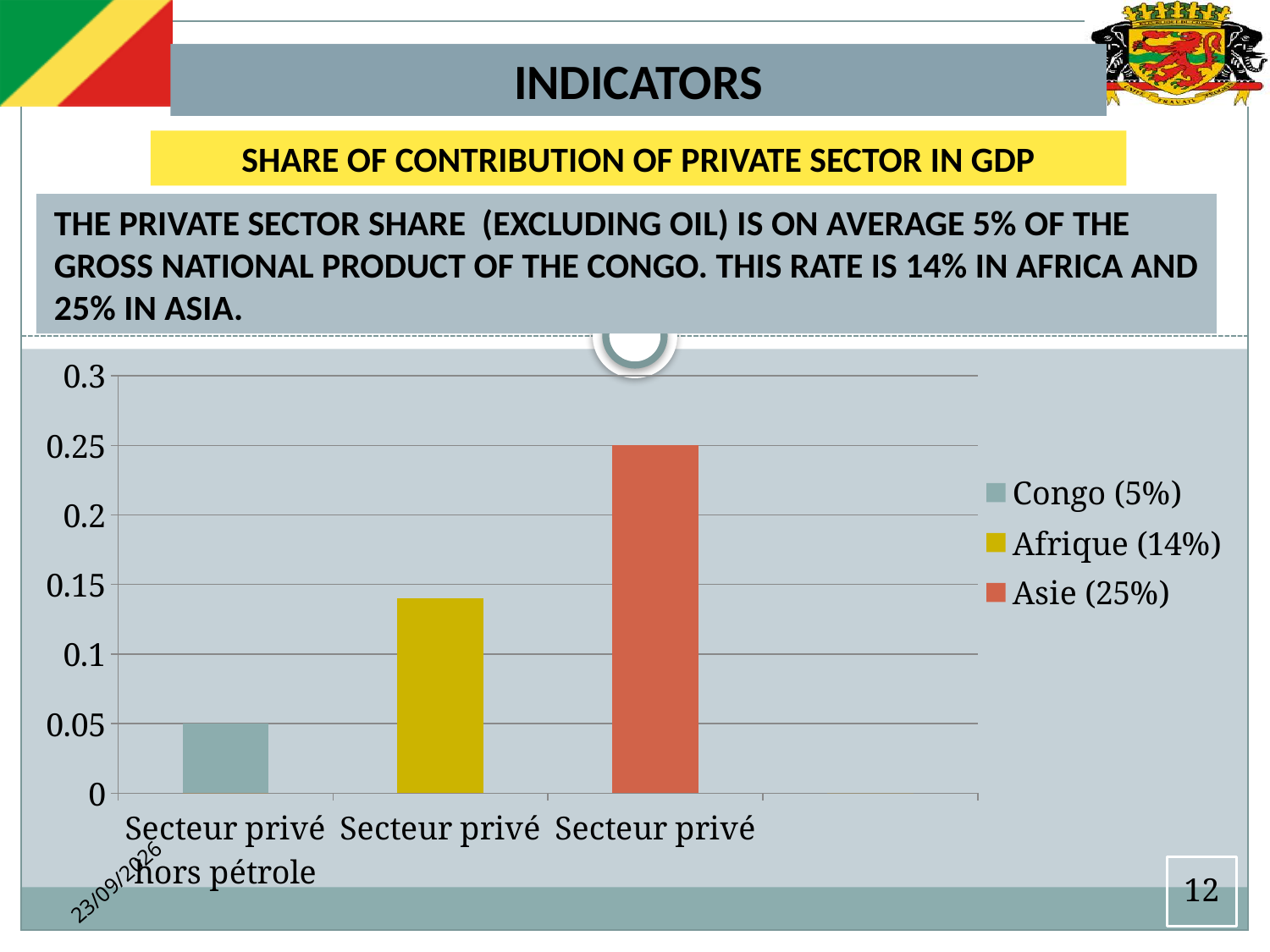
How many series does the chart legend list? 3 According to the legend, what is the private sector share for Afrique? 14% According to the legend, what is the private sector share for Congo? 5% How many bars are plotted in the chart? 3 Which series has the lowest bar in the chart? Congo (5%) Using the legend values, what is the difference between the Asie share and the Congo share? 20% Which series has the highest bar in the chart? Asie (25%) Is the bar for Afrique greater or less than 0.1 on the y axis? greater What kind of chart is shown on the slide? bar chart What colour is the bar for Asie in the chart? orange-red According to the legend, what is the private sector share for Asie? 25% Which bar is taller, Afrique or Congo? Afrique